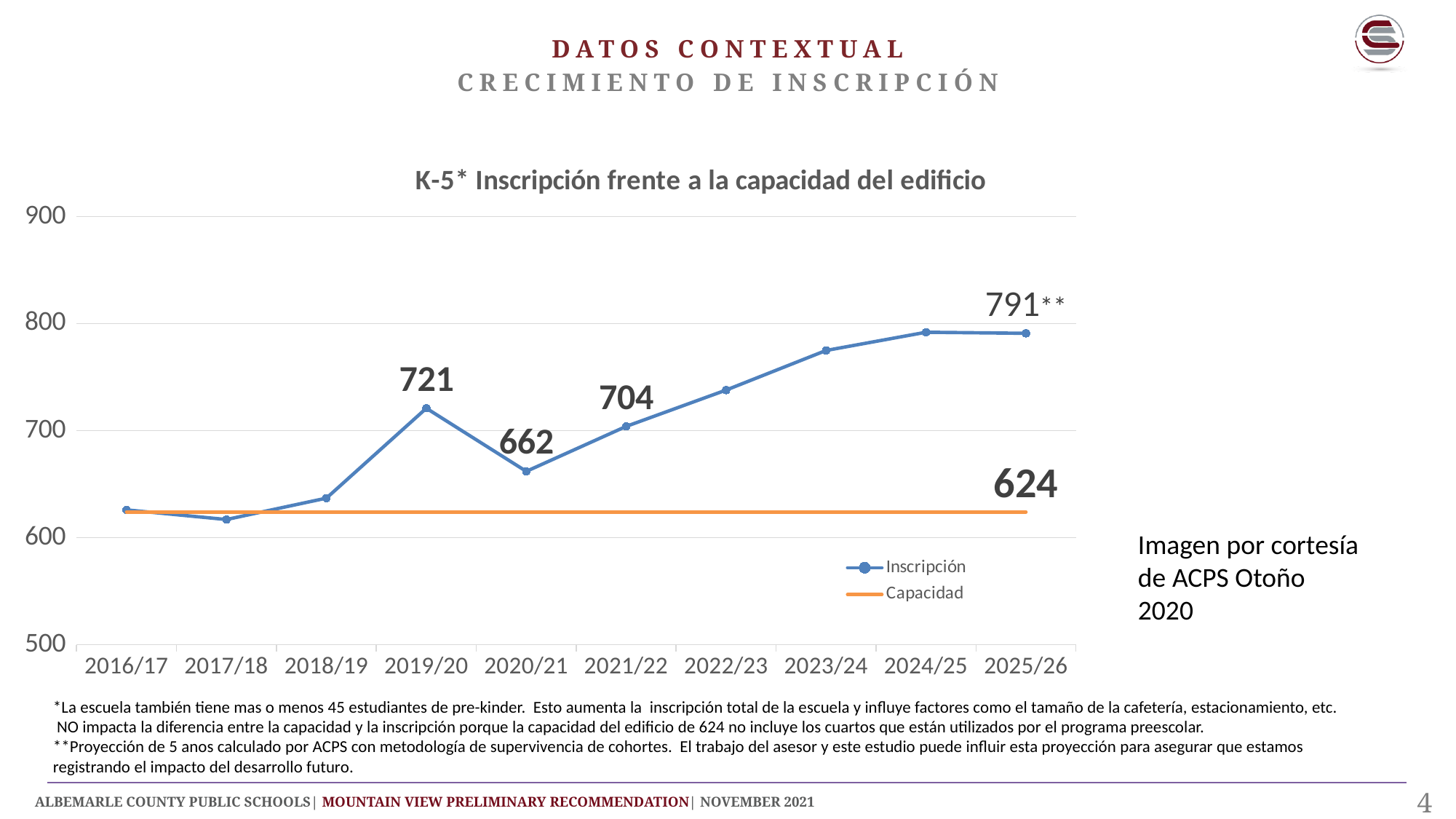
What kind of chart is shown on the slide? line chart How many school years are shown on the x axis? 10 Is the enrollment value for 2023/24 greater or less than 700? greater By how much does the projected 2025/26 enrollment exceed the building capacity of 624? 167 What is the building capacity (Capacidad) shown on the chart? 624 What is the difference between the enrollment in 2019/20 and in 2020/21? 59 What is the projected enrollment value for 2025/26? 791 What is the enrollment value for 2020/21? 662 Which year has higher enrollment, 2019/20 or 2021/22? 2019/20 What is the enrollment (Inscripción) value for 2019/20? 721 How many series does the legend list? 2 What is the enrollment value for 2021/22? 704